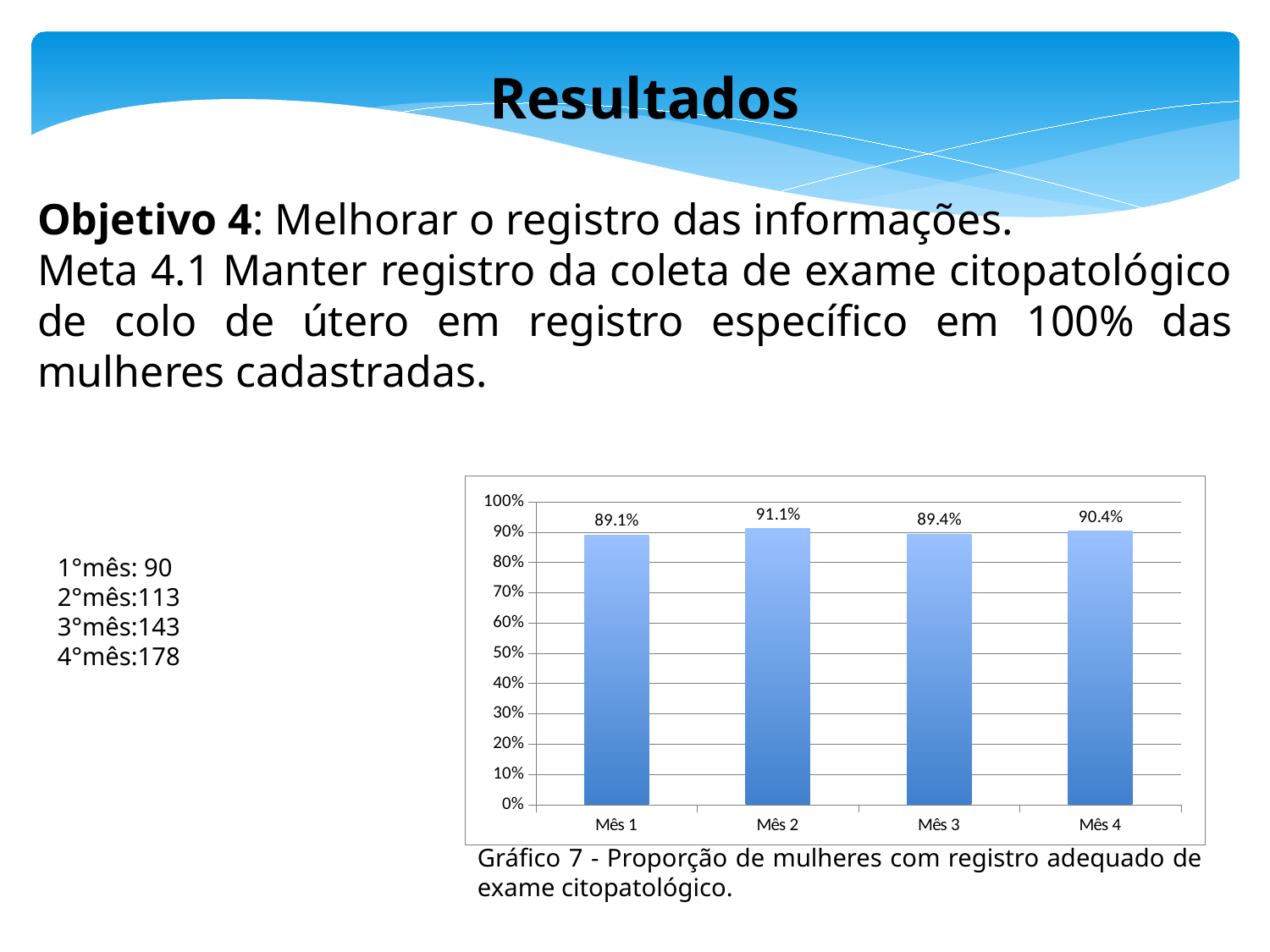
How many months are shown on the x axis? 4 What is the caption of the chart? Gráfico 7 - Proporção de mulheres com registro adequado de exame citopatológico. What is the value for Mês 4? 90.4% What is the value for Mês 2? 91.1% Which month has the highest value? Mês 2 Is the value for Mês 2 greater or less than 90%? greater What is the difference between the values for Mês 2 and Mês 1? 2.0% What kind of chart is shown? bar chart Which is larger, the value for Mês 4 or the value for Mês 3? Mês 4 Which month has the lowest value? Mês 1 What is the value for Mês 1? 89.1% What is the value for Mês 3? 89.4%